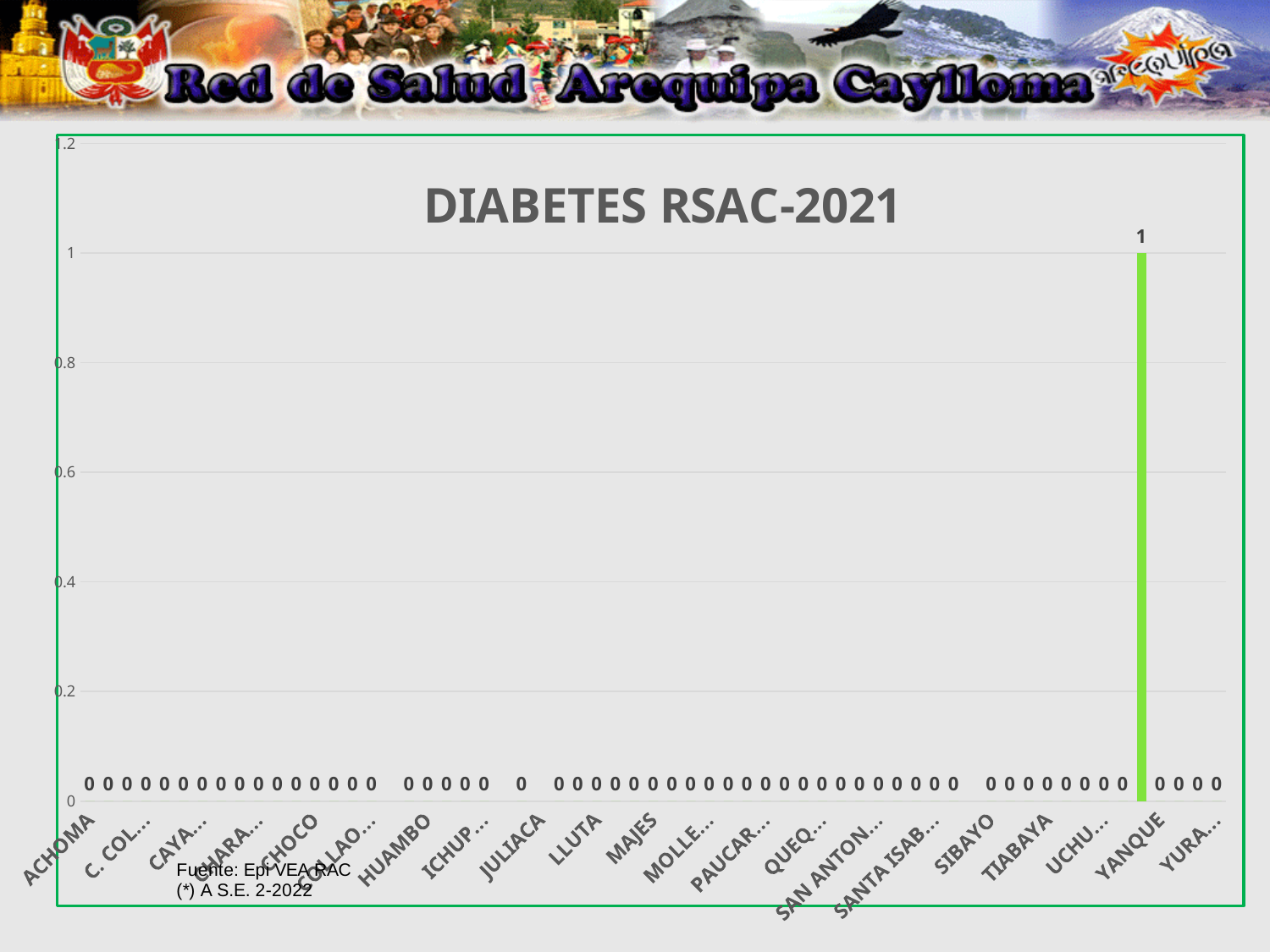
What is the value for MAJES? 0 Which is larger, the value for YANQUE or the value for LLUTA? Neither; both are 0 What is the value for HUAMBO? 0 What is the title of the chart? DIABETES RSAC-2021 What is the difference between the value for YANQUE and the value for TIABAYA? 0 What kind of chart is shown on the slide? bar chart What source is cited below the chart? Fuente: Epi VEA RAC What is the value for SIBAYO? 0 What is the value for YANQUE? 0 What is the value for ACHOMA? 0